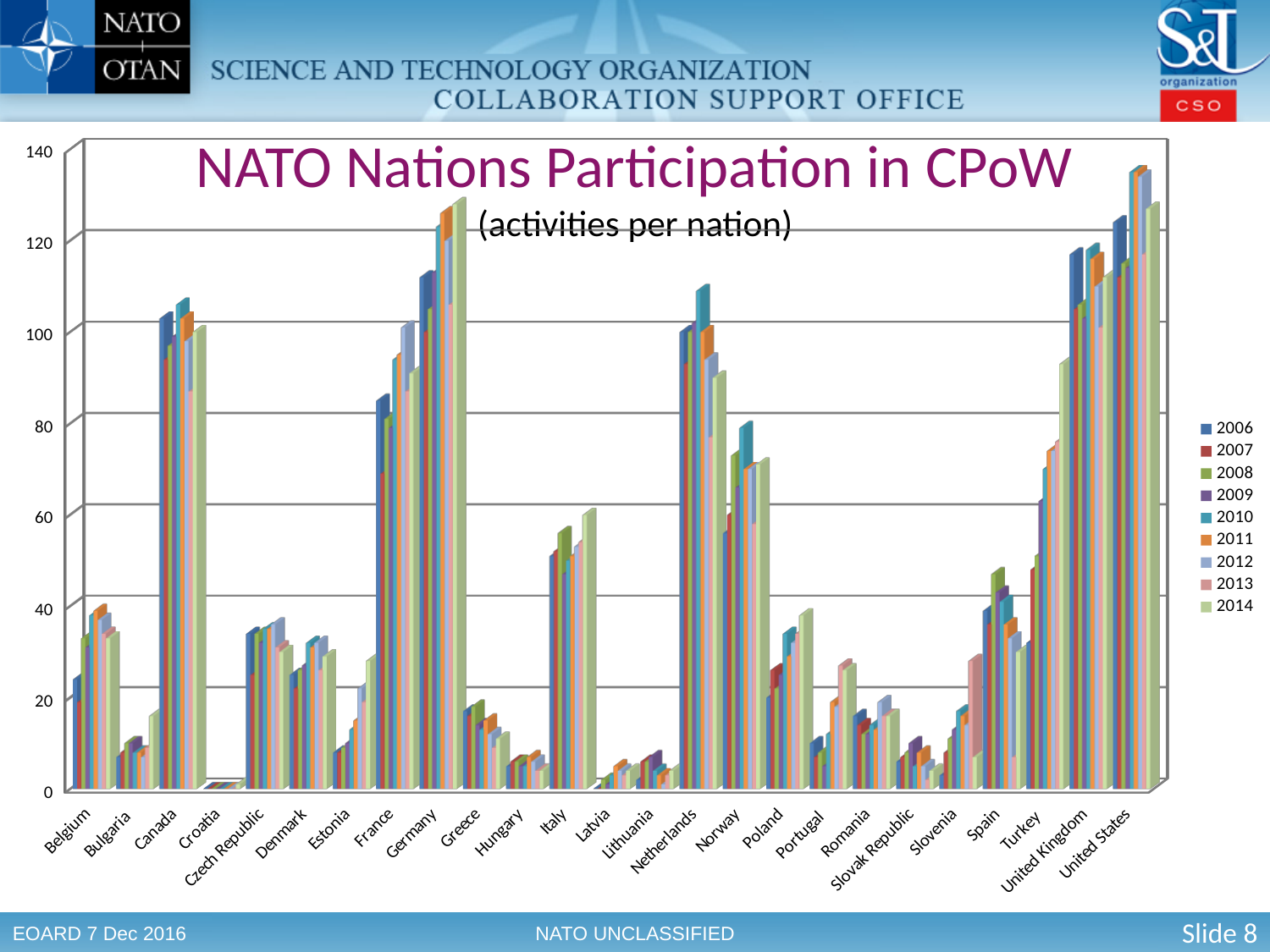
How many nations are shown along the x axis? 25 Which nation has the lowest bars overall in the chart? Croatia Is the value for Canada in 2006 greater or less than 80? greater Which nation has the larger value in 2014, Germany or Greece? Germany Which nation has the highest bars overall in the chart? United States Is the value for Latvia in 2014 greater or less than 20? less What is the title of the chart? NATO Nations Participation in CPoW (activities per nation) Is the value for Netherlands in 2010 greater or less than 100? greater What kind of chart is shown on the slide? bar chart Which year is the first series listed in the legend? 2006 How many series does the legend list? 9